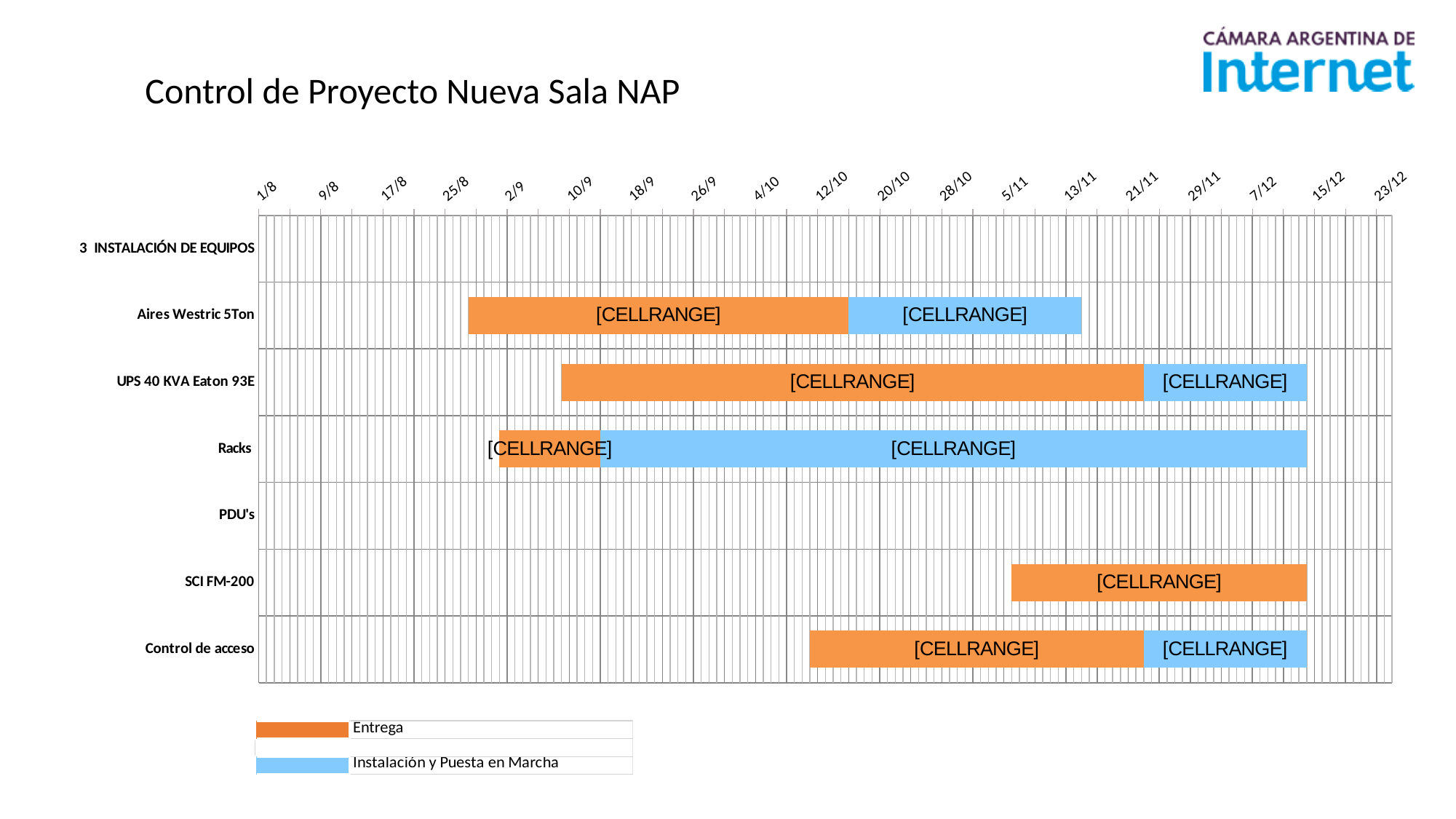
Which colour represents 'Entrega' in the chart? orange What kind of chart is shown on the slide? bar chart How many task rows (categories) are listed on the vertical axis of the chart? 7 What are the two entries in the chart legend? Entrega; Instalación y Puesta en Marcha Which task's Entrega bar starts earliest on the timeline? Aires Westric 5Ton Which task has the longest Instalación y Puesta en Marcha bar? Racks Which task rows have no bars plotted at all? 3 INSTALACIÓN DE EQUIPOS and PDU's Which task has the longest Entrega bar? UPS 40 KVA Eaton 93E Does the Entrega bar for Control de acceso start before or after 20/10? before Among the tasks with bars, which has the shortest Entrega bar? Racks How many series does the legend list? 2 Which task has only an Entrega bar and no Instalación y Puesta en Marcha bar? SCI FM-200